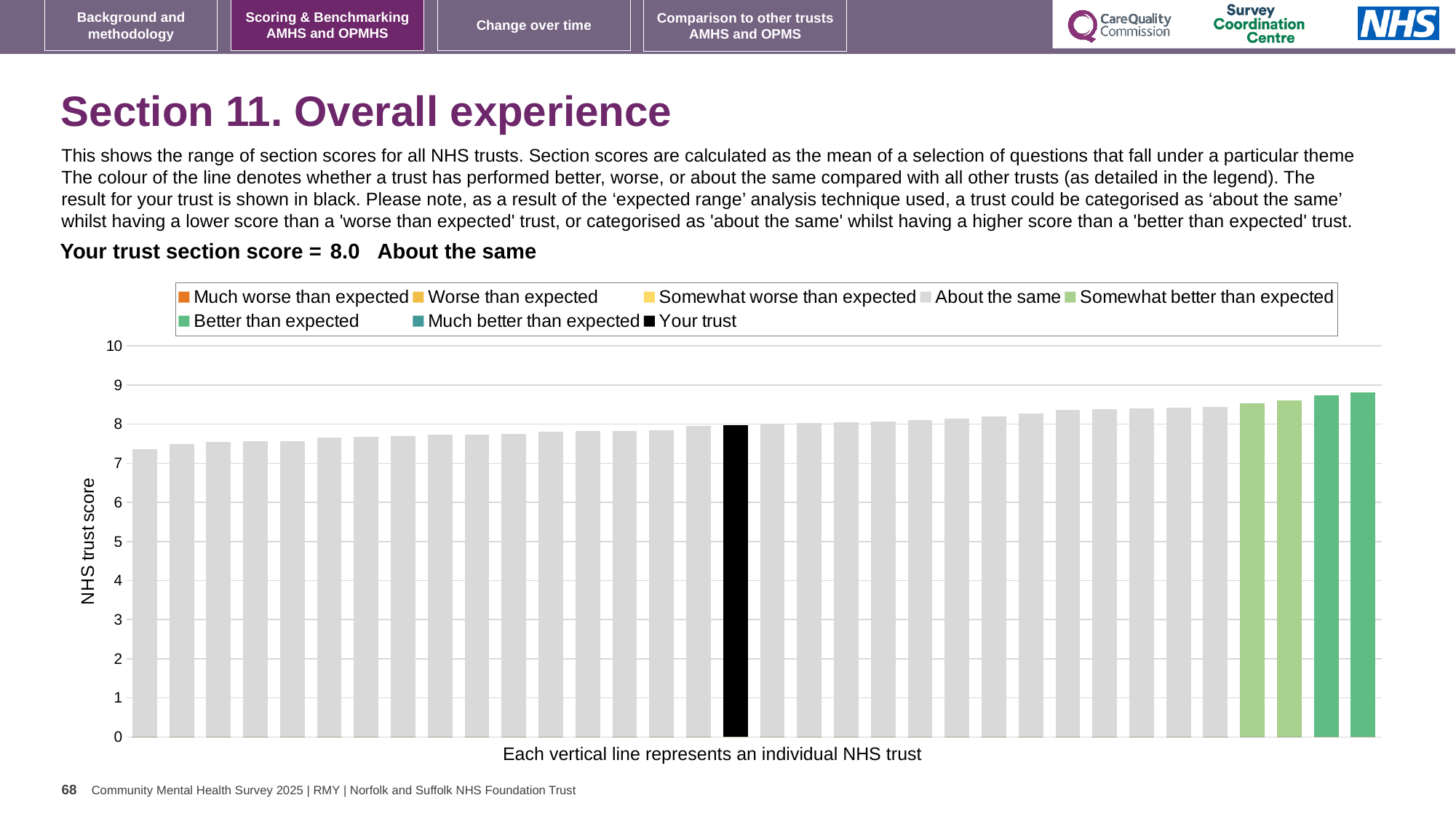
Is the value of the highest bar greater or less than 8? greater What is the section score for your trust shown on the slide? 8.0 Is the value of the lowest bar greater or less than 8? less What is the label on the vertical axis of the chart? NHS trust score What colour is the bar representing your trust? black Is the value of the highest bar greater or less than 9? less What kind of chart is shown on the slide? bar chart Do the bar values rise or fall from left to right along the x axis? rise Which category does your trust's section score fall into? About the same How many entries does the chart legend list? 8 Is the rightmost bar higher or lower than the black bar for your trust? higher